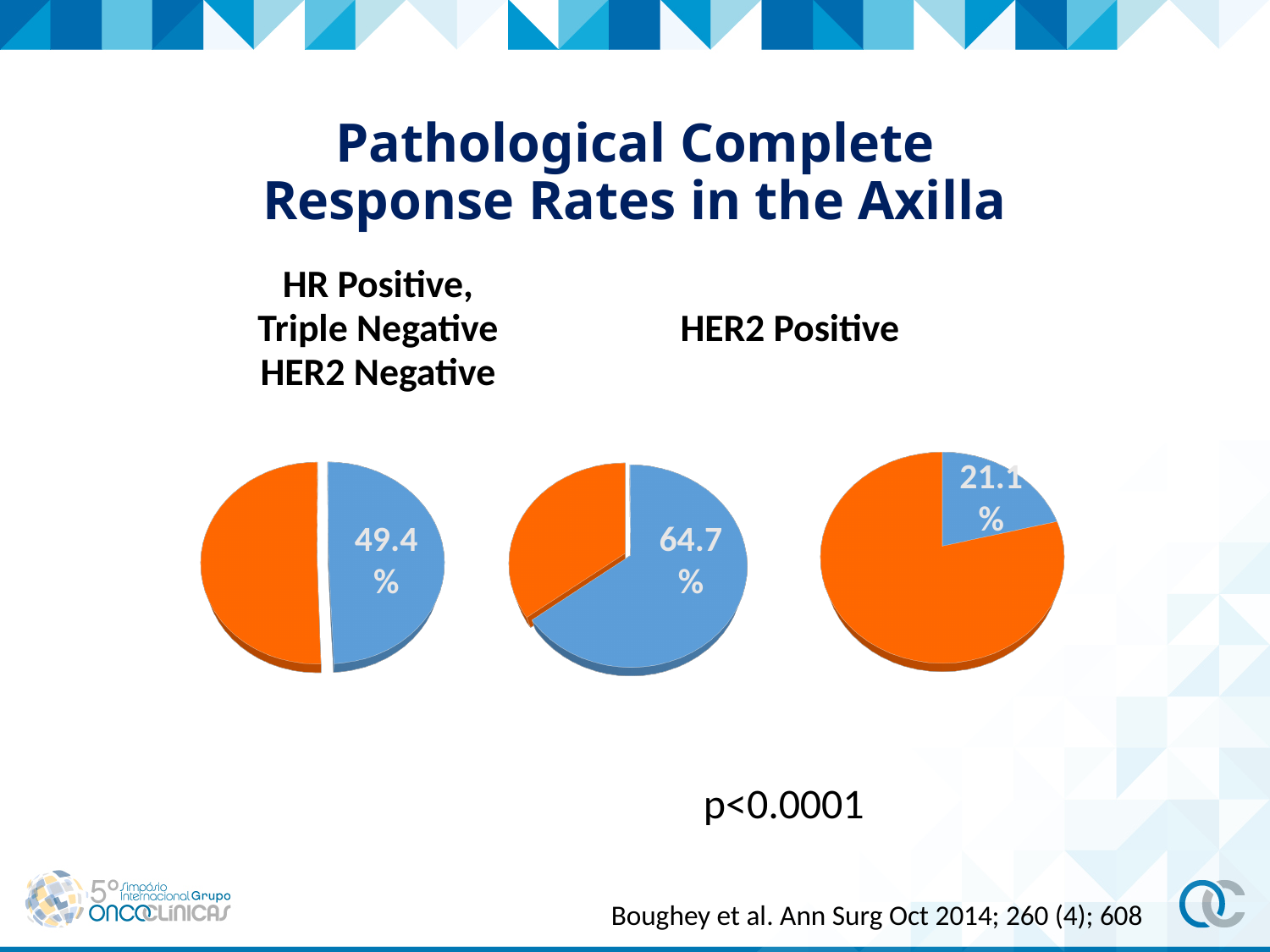
Which pie chart (left, middle or right) has the smallest labelled blue slice? Right What type of charts are shown on the slide? Pie charts Which pie chart (left, middle or right) has the largest labelled blue slice? Middle What is the title of the slide containing the pie charts? Pathological Complete Response Rates in the Axilla What share of the right pie chart does the blue slice represent? 21.1% What value is labelled on the blue slice of the left pie chart? 49.4% What value is labelled on the blue slice of the right pie chart? 21.1% What is the difference between the labelled values of the middle pie chart and the left pie chart? 15.3 percentage points How many pie charts are on the slide? 3 What is the difference between the labelled values of the middle pie chart and the right pie chart? 43.6 percentage points What value is labelled on the blue slice of the middle pie chart? 64.7% Is the labelled value in the middle pie chart larger than the labelled value in the left pie chart? Yes